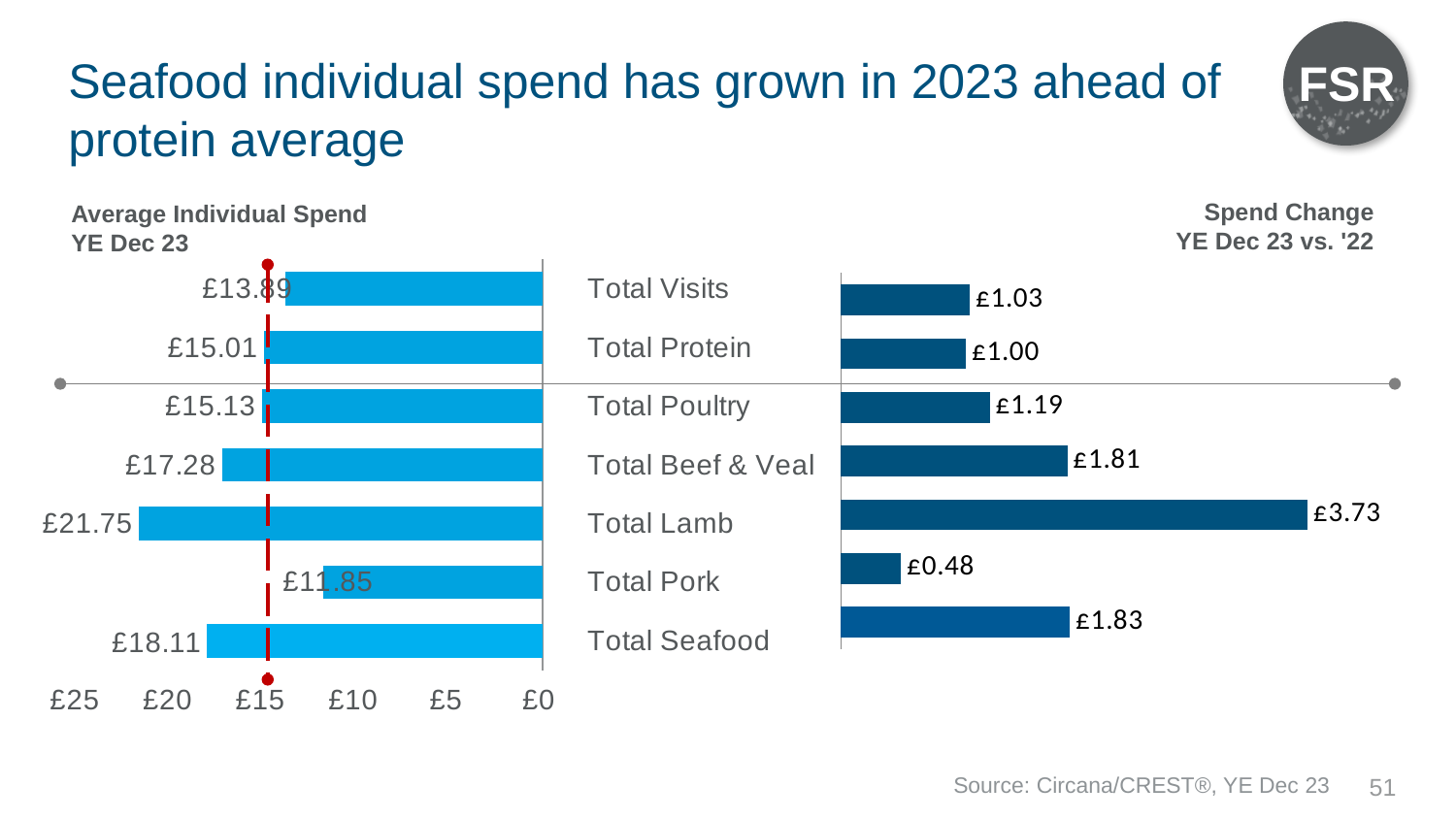
How many categories are shown in the Spend Change chart? 7 What kind of chart is the Average Individual Spend chart? Bar chart In the Average Individual Spend chart, which category has the lowest value? Total Pork In the Spend Change chart, what is the value for Total Seafood? £1.83 In the Spend Change chart, which category has the highest value? Total Lamb In the Average Individual Spend chart, what is the value for Total Lamb? £21.75 In the Spend Change chart, which category has the lowest value? Total Pork In the Average Individual Spend chart, what is the value for Total Seafood? £18.11 In the Spend Change chart, what is the value for Total Pork? £0.48 In the Spend Change chart, what is the difference between Total Seafood and Total Protein? £0.83 In the Average Individual Spend chart, what is the difference between Total Seafood and Total Protein? £3.10 In the Average Individual Spend chart, which is larger, Total Beef & Veal or Total Poultry? Total Beef & Veal